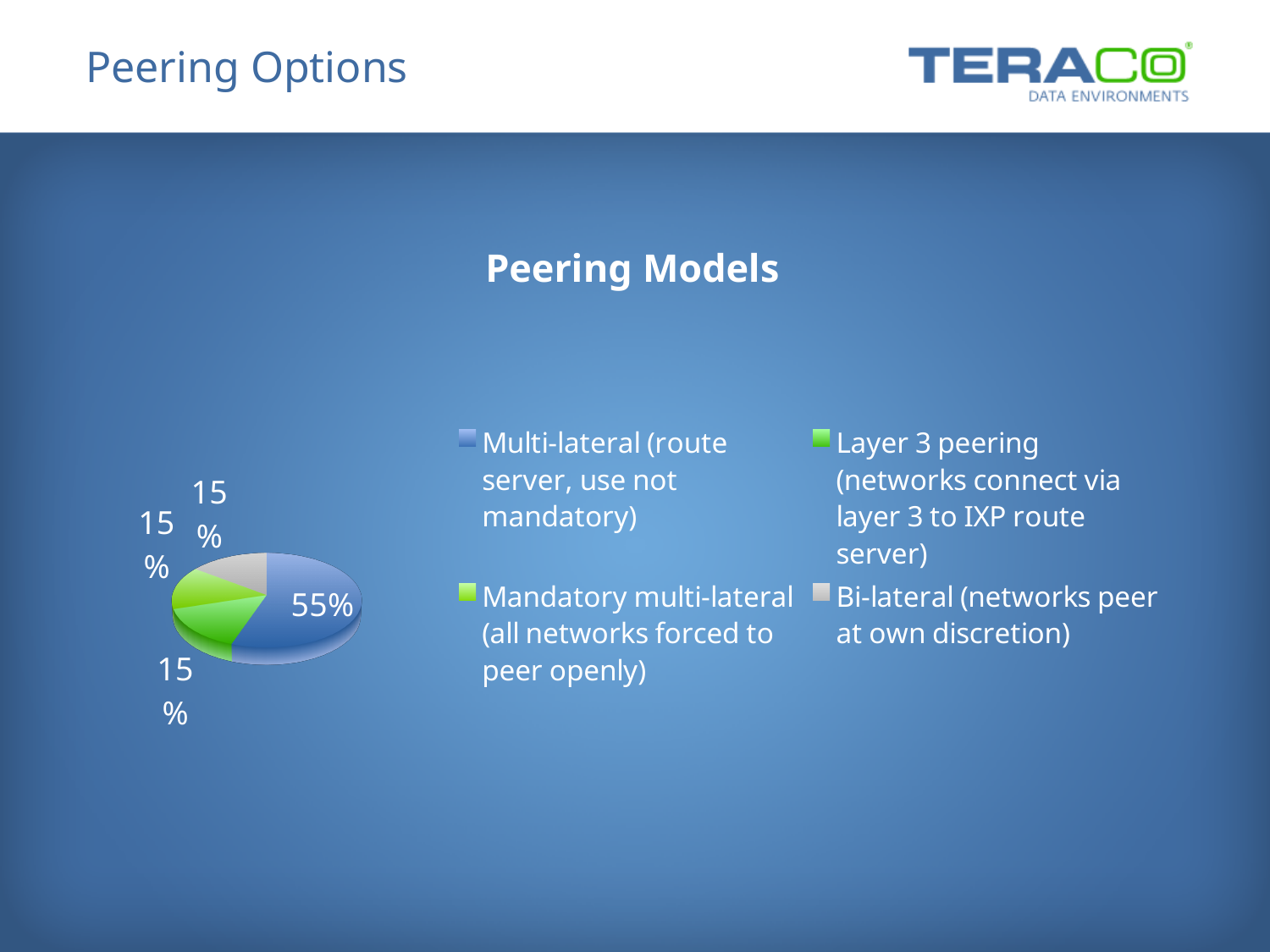
What type of chart is shown on the slide? pie chart What colour is the slice for Multi-lateral (route server, use not mandatory)? blue What is the value shown for Bi-lateral (networks peer at own discretion)? 15% What is the value shown for Layer 3 peering (networks connect via layer 3 to IXP route server)? 15% What share of the pie is Multi-lateral (route server, use not mandatory)? 55% What is the difference between the Multi-lateral (route server, use not mandatory) slice and the Bi-lateral (networks peer at own discretion) slice? 40 percentage points How many entries does the legend list? 4 Which peering model has the largest slice of the pie? Multi-lateral (route server, use not mandatory) What is the title of the chart? Peering Models How many slices does the pie chart have? 4 What is the value shown for Mandatory multi-lateral (all networks forced to peer openly)? 15% Which is larger: the slice for Multi-lateral (route server, use not mandatory) or the slice for Bi-lateral (networks peer at own discretion)? Multi-lateral (route server, use not mandatory)